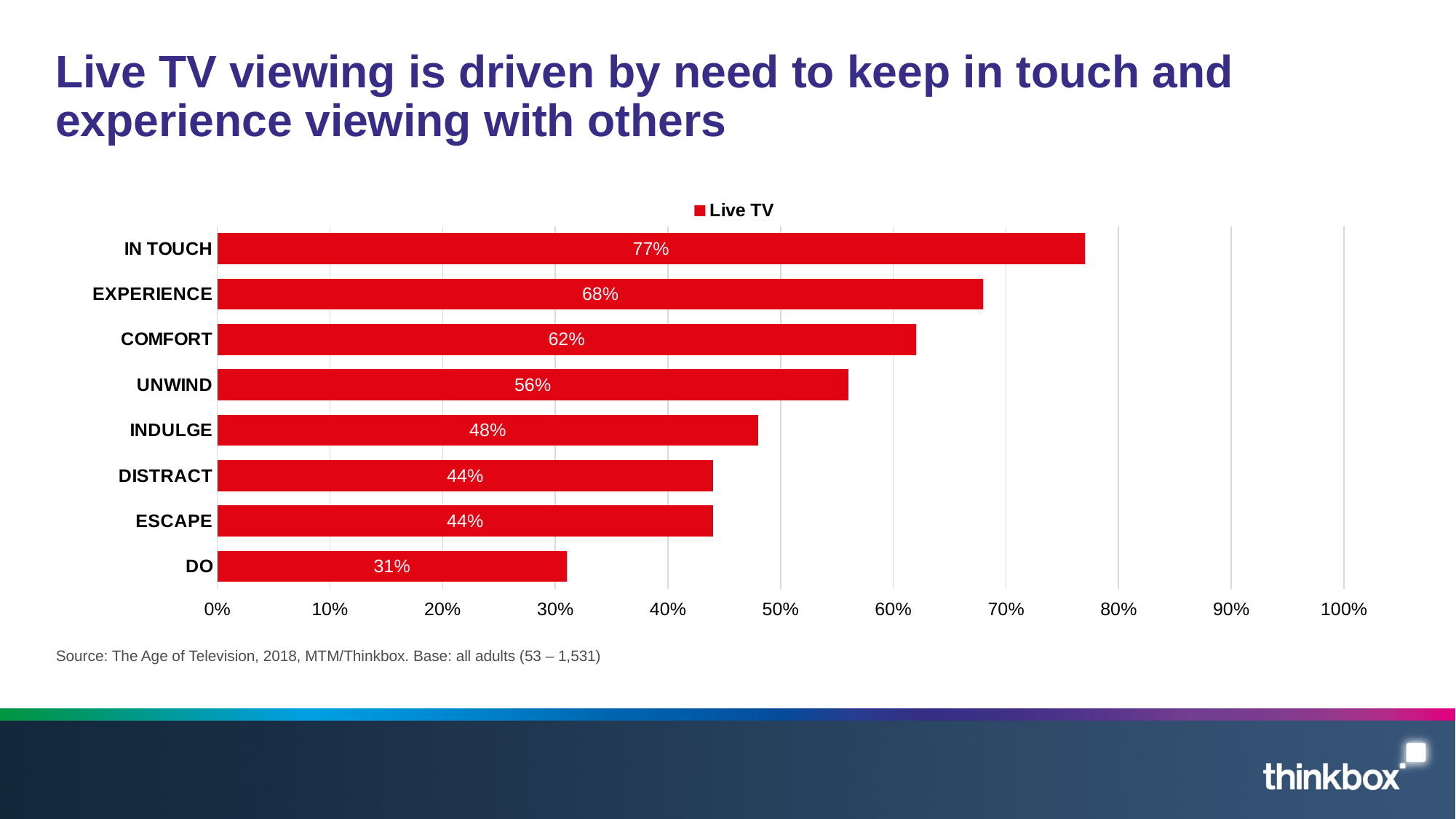
What is the value for IN TOUCH? 77% How many series does the legend list? 1 Is the value for COMFORT greater or less than 50%? greater What kind of chart is shown on the slide? Bar chart What is the value for UNWIND? 56% What is the difference between the values for IN TOUCH and EXPERIENCE? 9% Which is larger, the value for INDULGE or the value for DISTRACT? INDULGE Which category has the highest value? IN TOUCH Which category has the lowest value? DO How many categories are shown on the chart? 8 What is the difference between the values for COMFORT and DO? 31% What is the value for DO? 31%